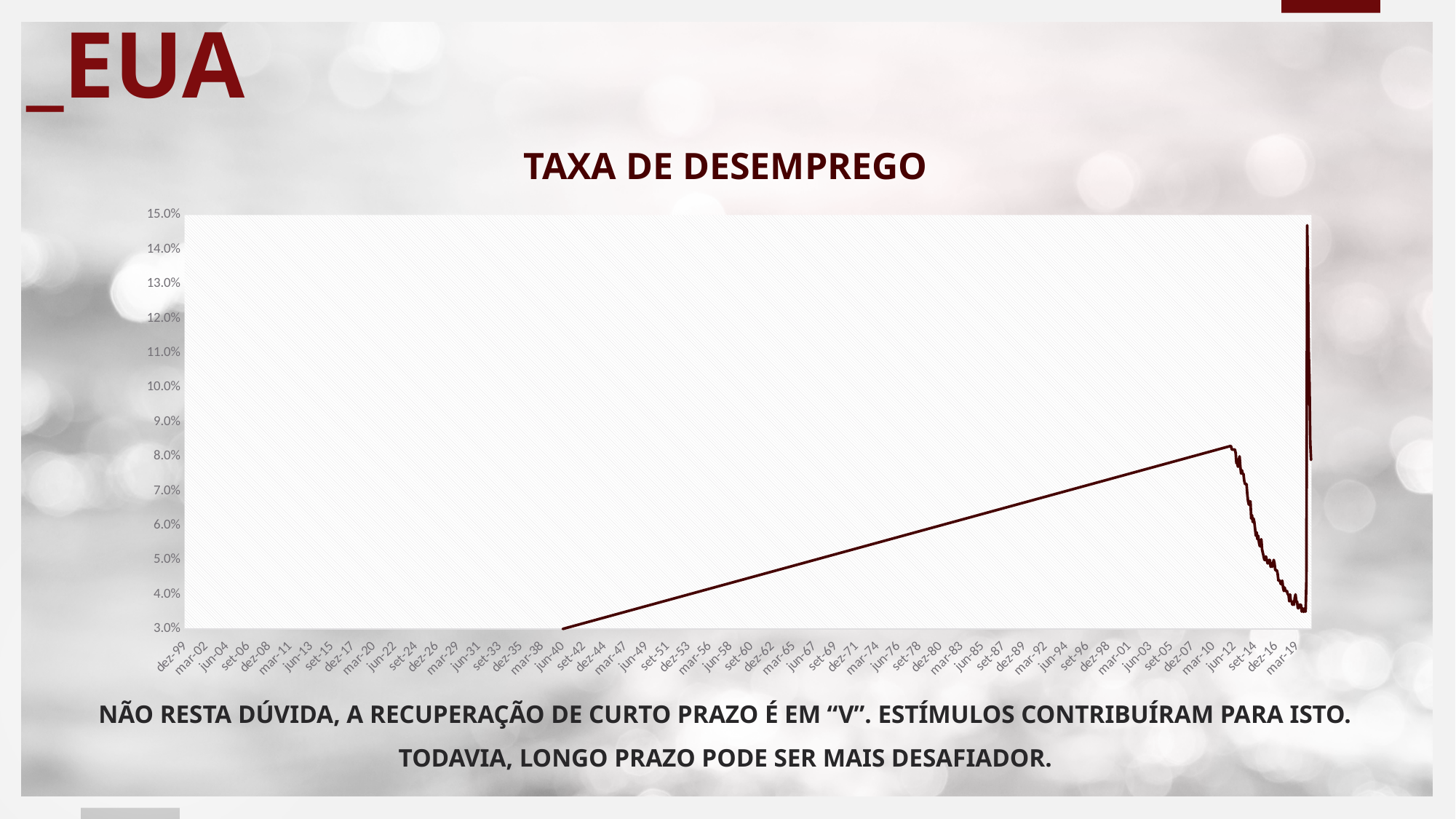
Where does the line reach its highest point: at jun-12 or at the far right end of the chart? the far right end of the chart What kind of chart is shown on the slide? line chart Is the peak value of the line, at the far right of the chart, greater or less than 14.0%? greater Is the value of the line at jun-40 greater or less than 4.0%? less Does the line rise or fall between jun-40 and jun-12? rise Does the line rise or fall between jun-12 and mar-19? fall How many lines are plotted on the chart? 1 Is the value of the line at jun-12 greater or less than 7.0%? greater What is the highest value shown on the vertical axis of the chart? 15.0% What is the title of the chart? TAXA DE DESEMPREGO Which is larger, the value of the line at jun-12 or the value at mar-19? jun-12